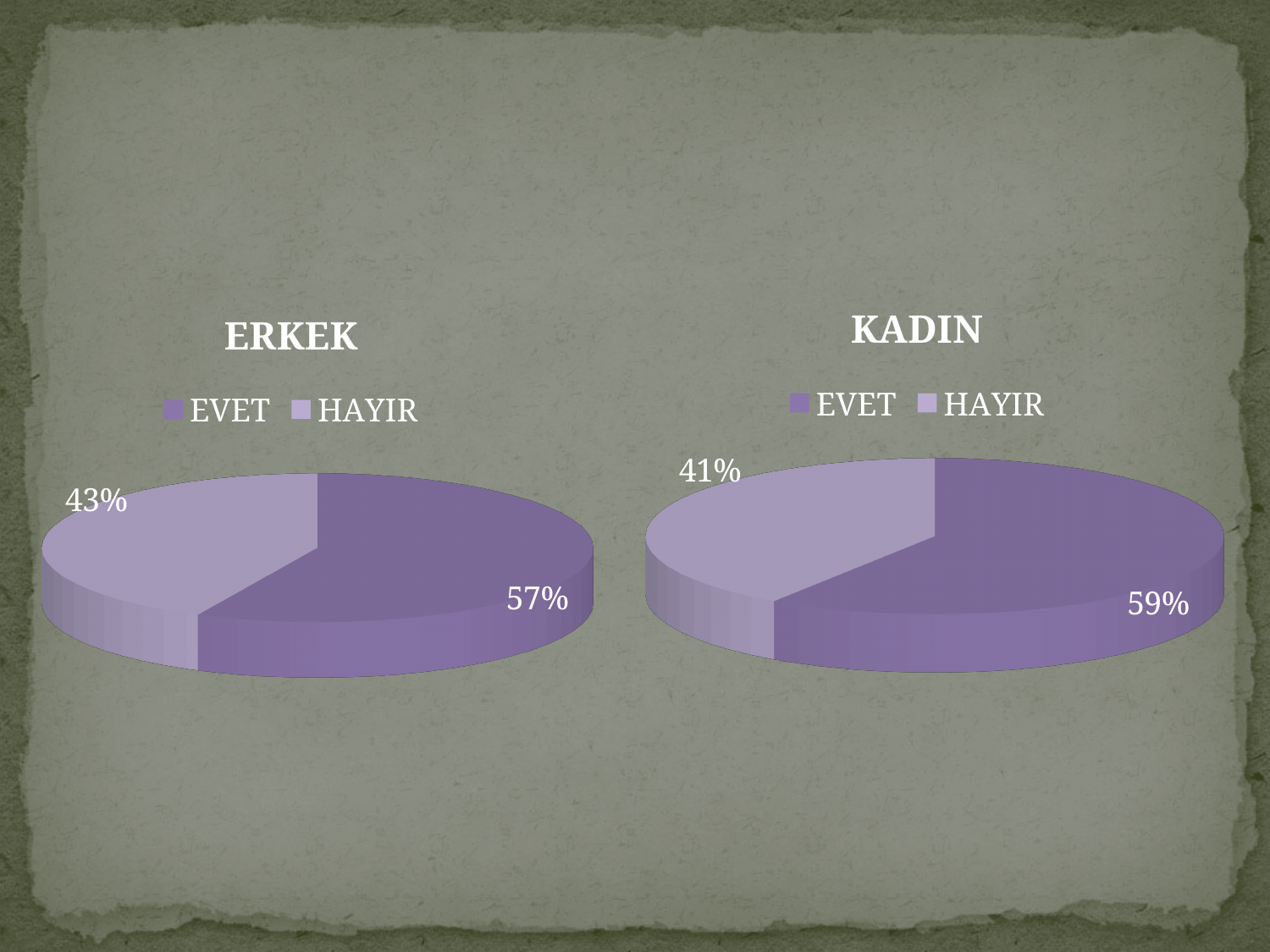
What are the legend entries of the KADIN chart? EVET, HAYIR In the ERKEK chart, which slice is the largest? EVET In the KADIN chart, what share of the pie is HAYIR? 41% In the ERKEK chart, what share of the pie is EVET? 57% In the KADIN chart, what is the difference between the EVET and HAYIR shares? 18% In the KADIN chart, what share of the pie is EVET? 59% In the KADIN chart, which slice is the smallest? HAYIR What kind of chart is the ERKEK chart? Pie chart How many slices does the KADIN chart have? 2 Which is larger: the EVET share in the ERKEK chart or the EVET share in the KADIN chart? KADIN In the ERKEK chart, what is the difference between the EVET and HAYIR shares? 14%